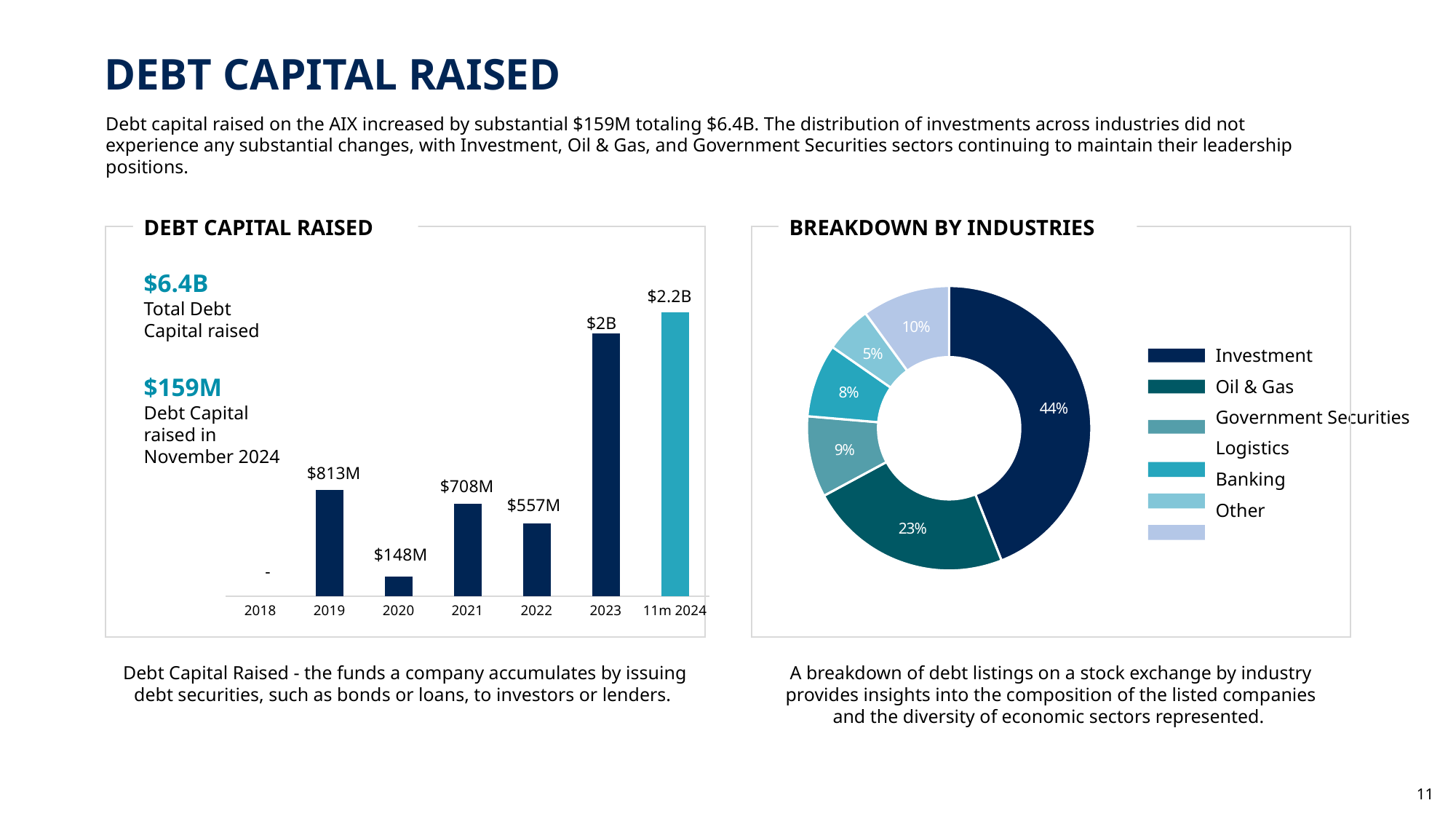
In the DEBT CAPITAL RAISED bar chart, which period has the tallest bar? 11m 2024 In the BREAKDOWN BY INDUSTRIES chart, what share does Investment have? 44% How many periods are shown on the x axis of the DEBT CAPITAL RAISED chart? 7 In the BREAKDOWN BY INDUSTRIES chart, what share does Oil & Gas have? 23% In the DEBT CAPITAL RAISED bar chart, what value is shown for 2023? $2B In the DEBT CAPITAL RAISED bar chart, how much larger is the 2019 value than the 2021 value? $105M In the BREAKDOWN BY INDUSTRIES chart, which industry has the largest slice? Investment In the DEBT CAPITAL RAISED bar chart, which year has the larger value, 2021 or 2022? 2021 In the BREAKDOWN BY INDUSTRIES chart, what share does Government Securities have? 9% What kind of chart is the DEBT CAPITAL RAISED chart? Bar chart In the DEBT CAPITAL RAISED bar chart, what value is shown for 2019? $813M In the DEBT CAPITAL RAISED bar chart, which year has the shortest bar? 2020